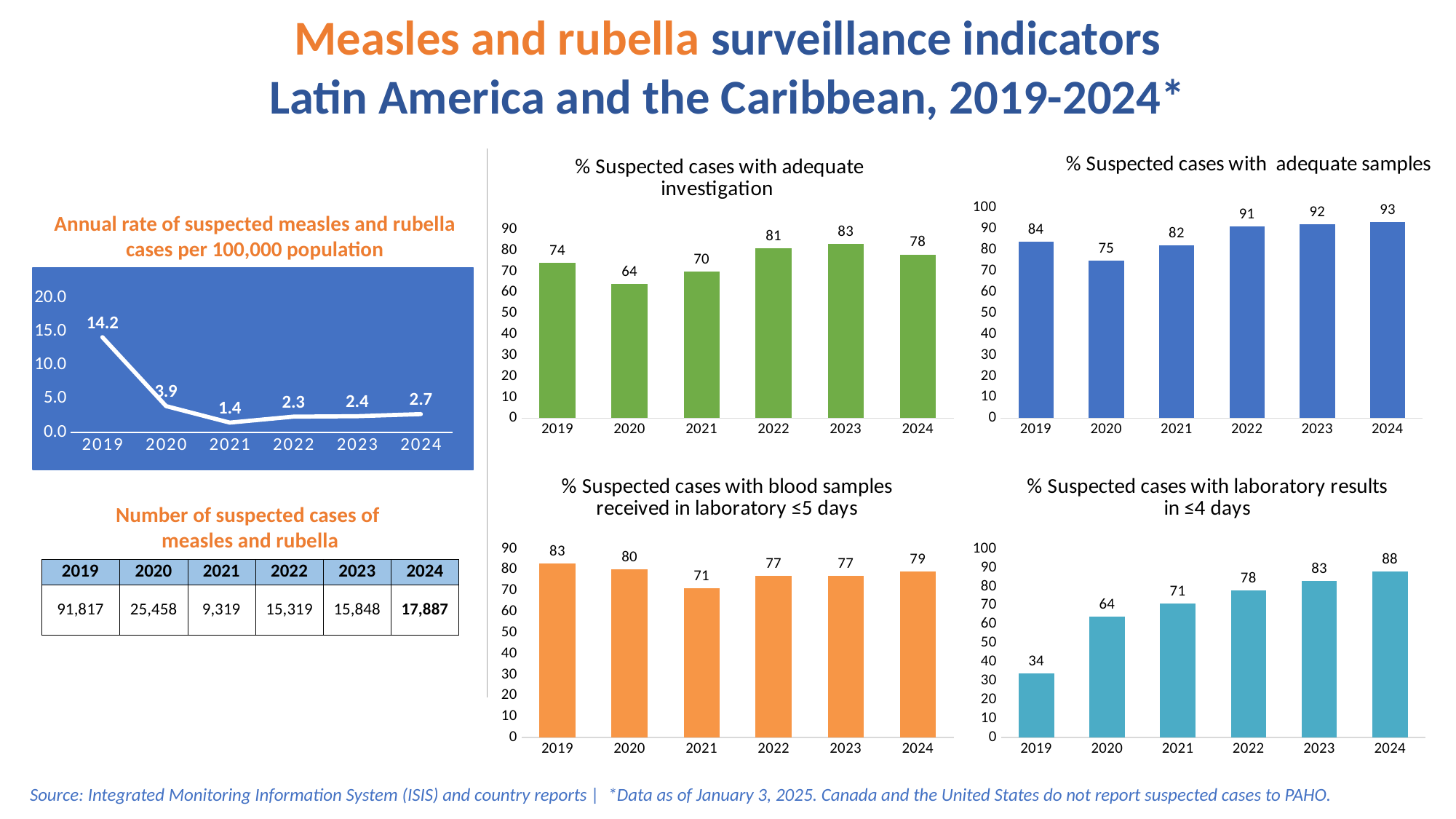
In the '% Suspected cases with blood samples received in laboratory ≤5 days' chart, what is the value for 2021? 71 In the '% Suspected cases with adequate samples' chart, what is the difference between the values for 2024 and 2020? 18 What kind of chart is the 'Annual rate of suspected measles and rubella cases per 100,000 population' chart? line chart In the '% Suspected cases with laboratory results in ≤4 days' chart, what is the value for 2019? 34 In the 'Annual rate of suspected measles and rubella cases per 100,000 population' chart, what is the value for 2019? 14.2 In the '% Suspected cases with laboratory results in ≤4 days' chart, do the values rise or fall from 2019 to 2024? rise In the '% Suspected cases with blood samples received in laboratory ≤5 days' chart, which is larger, the value for 2019 or the value for 2024? 2019 In the '% Suspected cases with adequate investigation' chart, what is the value for 2022? 81 What colour are the bars in the '% Suspected cases with blood samples received in laboratory ≤5 days' chart? orange In the 'Annual rate of suspected measles and rubella cases per 100,000 population' chart, which year has the lowest value? 2021 In the '% Suspected cases with adequate samples' chart, how many years are shown on the x axis? 6 In the '% Suspected cases with adequate investigation' chart, which year has the highest value? 2023